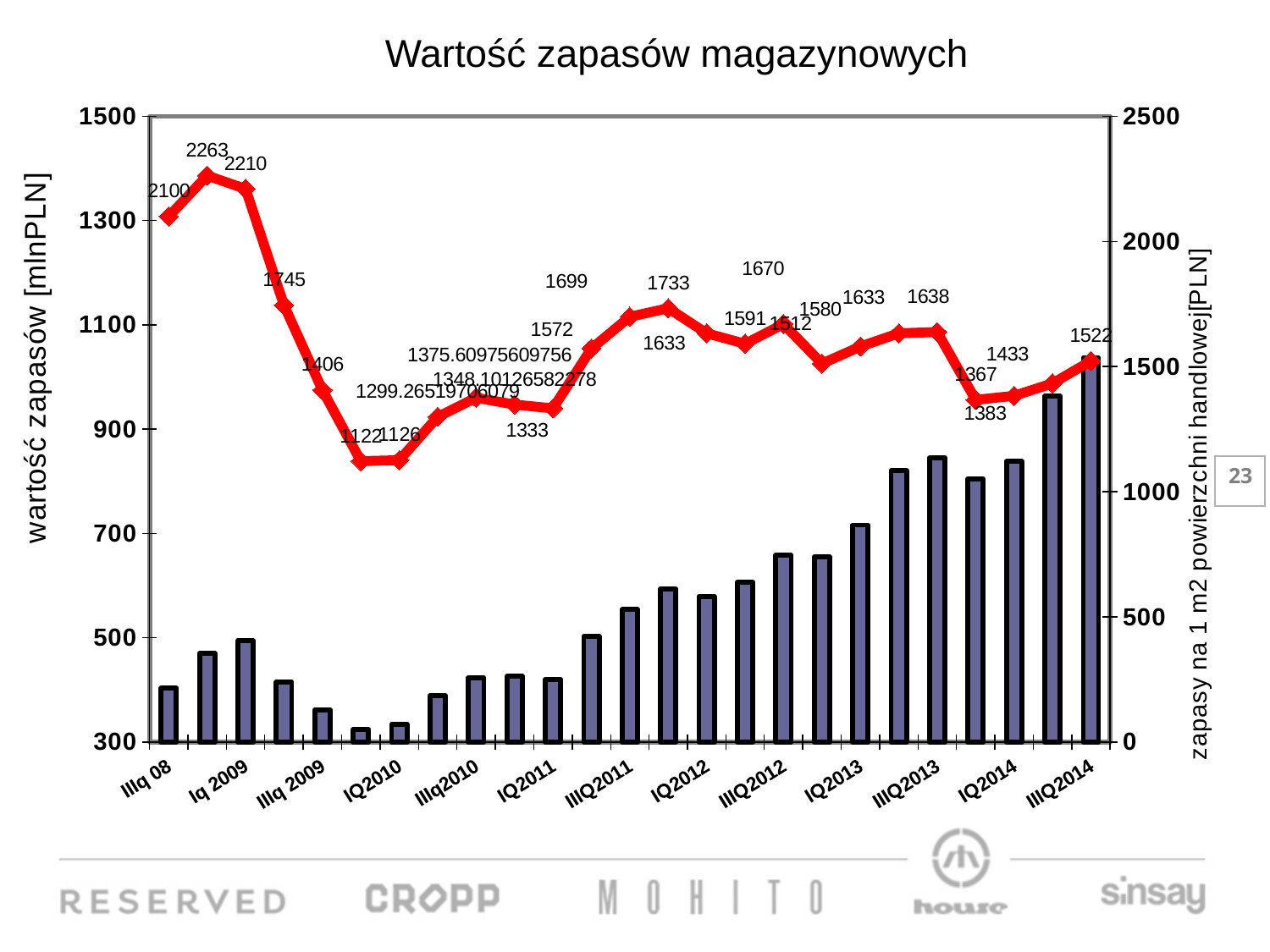
What kind of chart is shown on the slide? Combined bar and line chart What is the lowest value labelled on the red line? 1122 What is the highest value labelled on the red line? 2263 What is the value of the red line for IIIQ2014? 1522 What is the title of the chart? Wartość zapasów magazynowych By how much does the red line value for Iq 2009 exceed the value for IIIq 08? 110 What is the value of the red line (zapasy na 1 m2) for IIIq 08? 2100 What is the value of the red line for Iq 2009? 2210 Is the bar value (wartość zapasów) for IIIQ2014 greater or less than 900 mlnPLN? greater What is the value of the red line for IQ2014? 1383 What is the value of the red line for IIIq 2009? 1406 Is the bar value (wartość zapasów) for IQ2010 greater or less than 500 mlnPLN? less